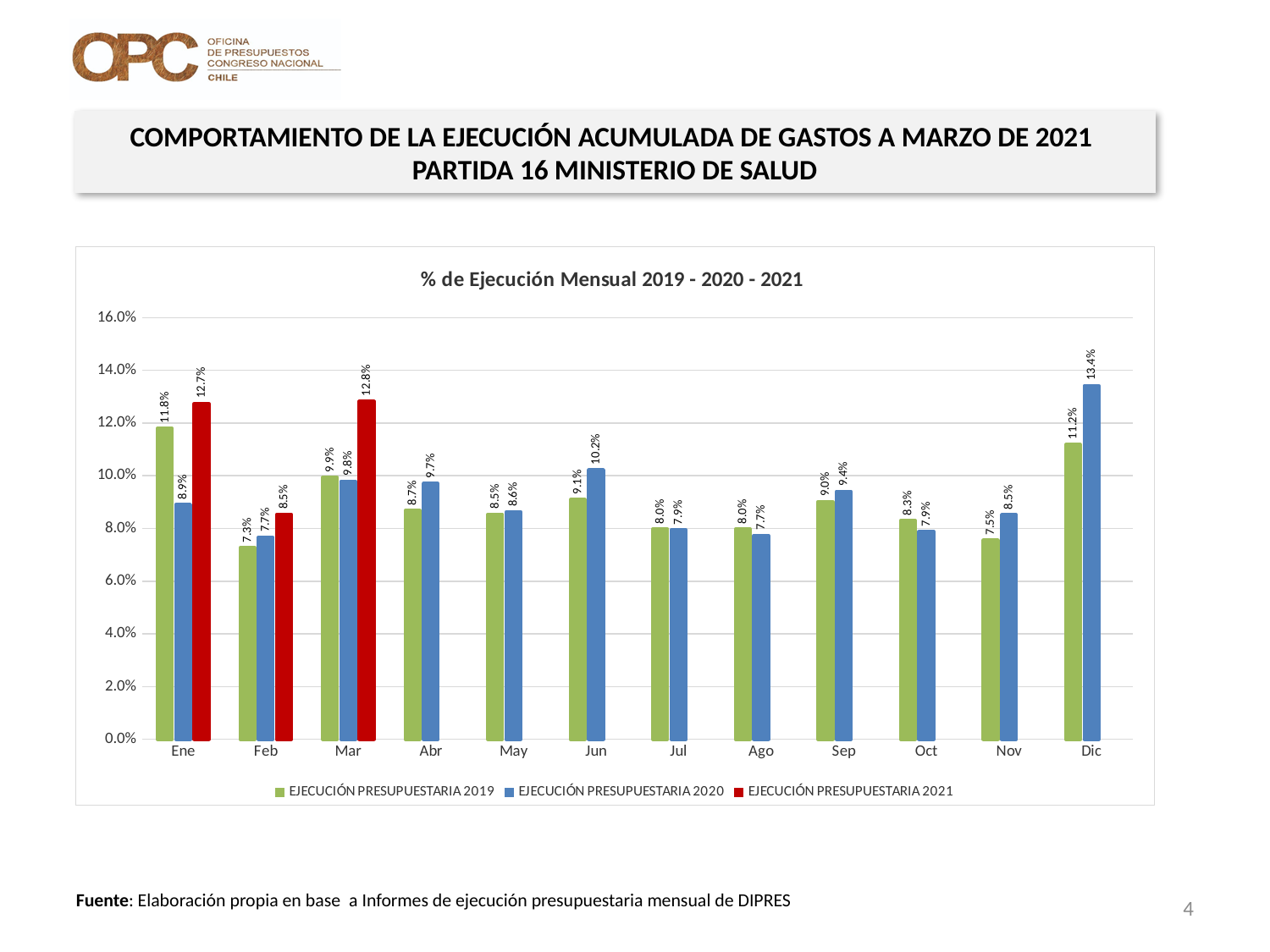
Which month has the lowest value for EJECUCIÓN PRESUPUESTARIA 2019? Feb What is the difference between EJECUCIÓN PRESUPUESTARIA 2021 and EJECUCIÓN PRESUPUESTARIA 2019 in Ene? 0.9% What is the value for EJECUCIÓN PRESUPUESTARIA 2020 in Dic? 13.4% Is the value for EJECUCIÓN PRESUPUESTARIA 2020 in Nov greater or less than 10.0%? less What kind of chart is shown? Bar chart Which month has the highest value for EJECUCIÓN PRESUPUESTARIA 2020? Dic How many series does the legend list? 3 What is the value for EJECUCIÓN PRESUPUESTARIA 2019 in Ene? 11.8% What colour represents EJECUCIÓN PRESUPUESTARIA 2021? Red Which is larger in Jun: EJECUCIÓN PRESUPUESTARIA 2019 or EJECUCIÓN PRESUPUESTARIA 2020? EJECUCIÓN PRESUPUESTARIA 2020 What is the value for EJECUCIÓN PRESUPUESTARIA 2021 in Mar? 12.8% How many months are shown on the x axis? 12